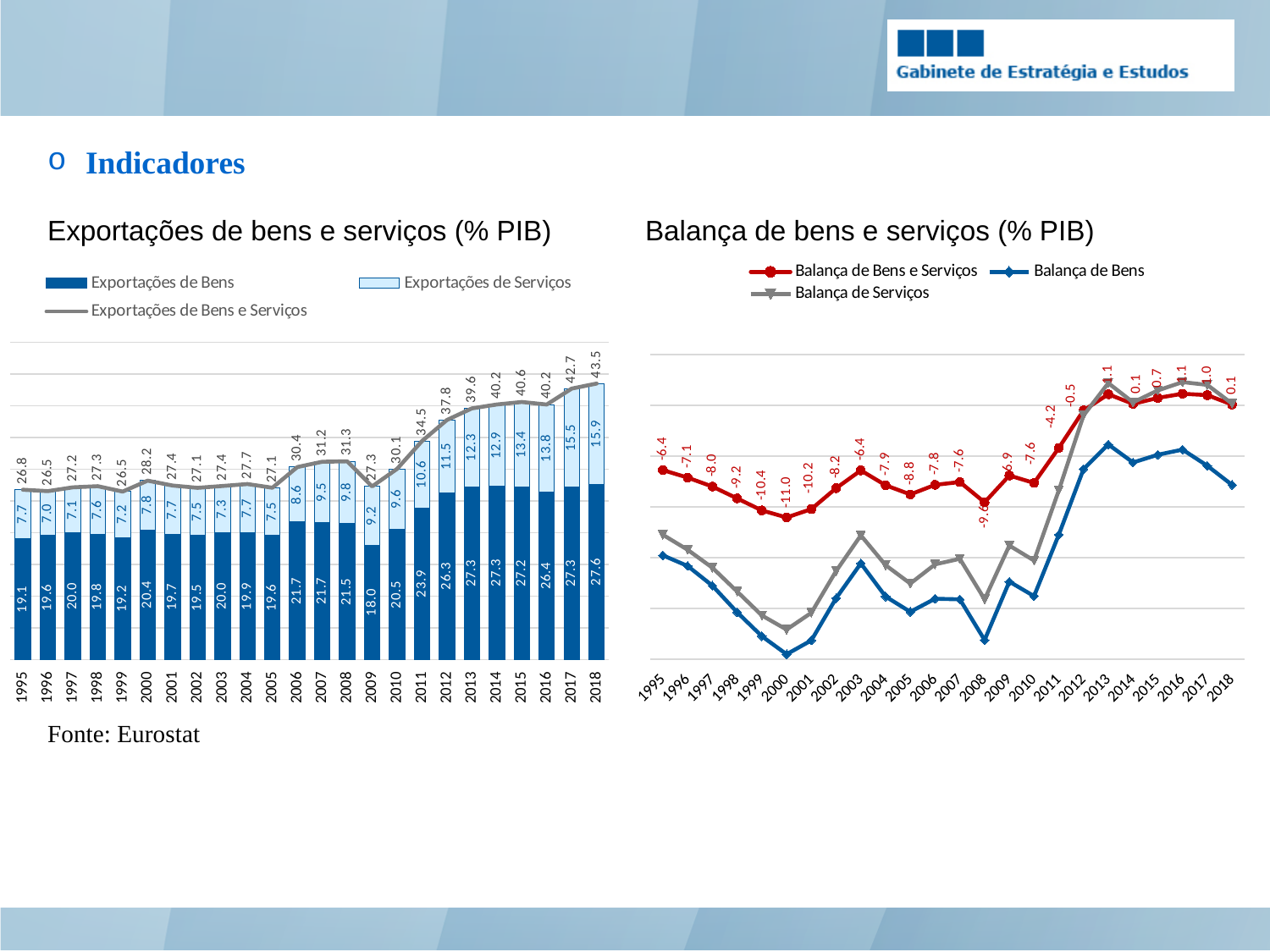
In the right chart 'Balança de bens e serviços (% PIB)', in which year is Balança de Bens e Serviços at its lowest? 2000 In the right chart 'Balança de bens e serviços (% PIB)', does Balança de Bens e Serviços rise or fall between 2008 and 2013? Rises In the left chart 'Exportações de bens e serviços (% PIB)', how much higher is Exportações de Bens in 2018 than in 1995? 8.5 In the left chart 'Exportações de bens e serviços (% PIB)', which year has the larger value of Exportações de Serviços, 2016 or 2017? 2017 How many series does the legend of the right chart 'Balança de bens e serviços (% PIB)' list? 3 In the left chart 'Exportações de bens e serviços (% PIB)', what is the total of the stacked bar for 2018? 43.5 How many years are shown on the x axis of the left chart 'Exportações de bens e serviços (% PIB)'? 24 In the right chart 'Balança de bens e serviços (% PIB)', what is the value of Balança de Bens e Serviços for 2011? -4.2 In the left chart 'Exportações de bens e serviços (% PIB)', which year has the highest value of Exportações de Bens e Serviços? 2018 In the left chart 'Exportações de bens e serviços (% PIB)', what is the value of Exportações de Bens for 2018? 27.6 What kind of chart is the left chart, 'Exportações de bens e serviços (% PIB)'? Bar chart (stacked, with a line) In the left chart 'Exportações de bens e serviços (% PIB)', what is the value of Exportações de Serviços for 2009? 9.2